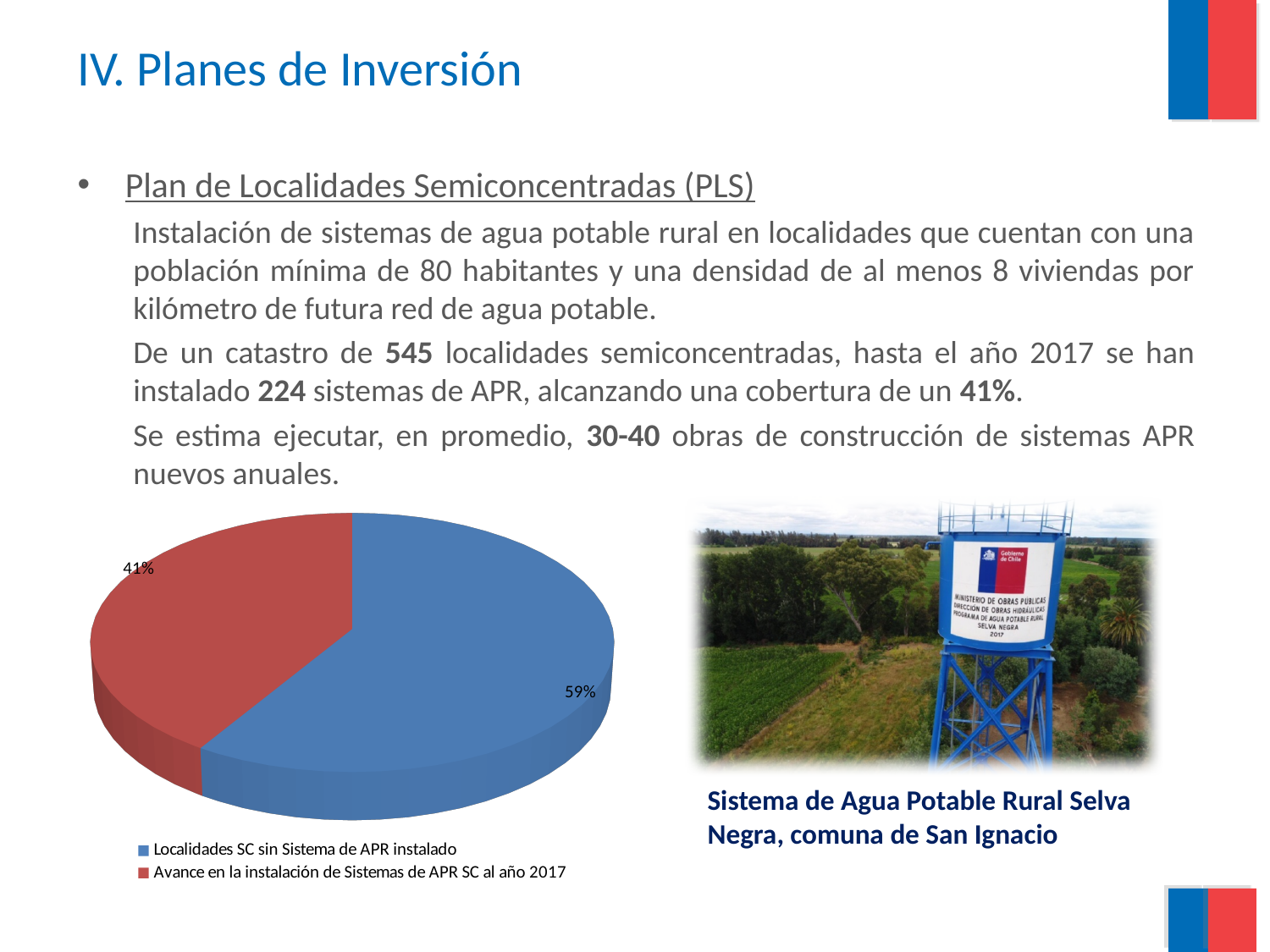
Which slice of the pie chart is the smallest? Avance en la instalación de Sistemas de APR SC al año 2017 What colour is the slice for 'Avance en la instalación de Sistemas de APR SC al año 2017'? Red What share of the pie is labelled 'Localidades SC sin Sistema de APR instalado'? 59% Which is larger: the share for 'Localidades SC sin Sistema de APR instalado' or the share for 'Avance en la instalación de Sistemas de APR SC al año 2017'? Localidades SC sin Sistema de APR instalado How many slices does the pie chart have? 2 What share of the pie is labelled 'Avance en la instalación de Sistemas de APR SC al año 2017'? 41% Is the share for 'Avance en la instalación de Sistemas de APR SC al año 2017' greater or less than 50%? less What kind of chart is shown on the slide? Pie chart What is the difference in percentage points between the two slices of the pie chart? 18 percentage points How many entries does the legend of the pie chart list? 2 What colour is the slice for 'Localidades SC sin Sistema de APR instalado'? Blue Which slice of the pie chart is the largest? Localidades SC sin Sistema de APR instalado